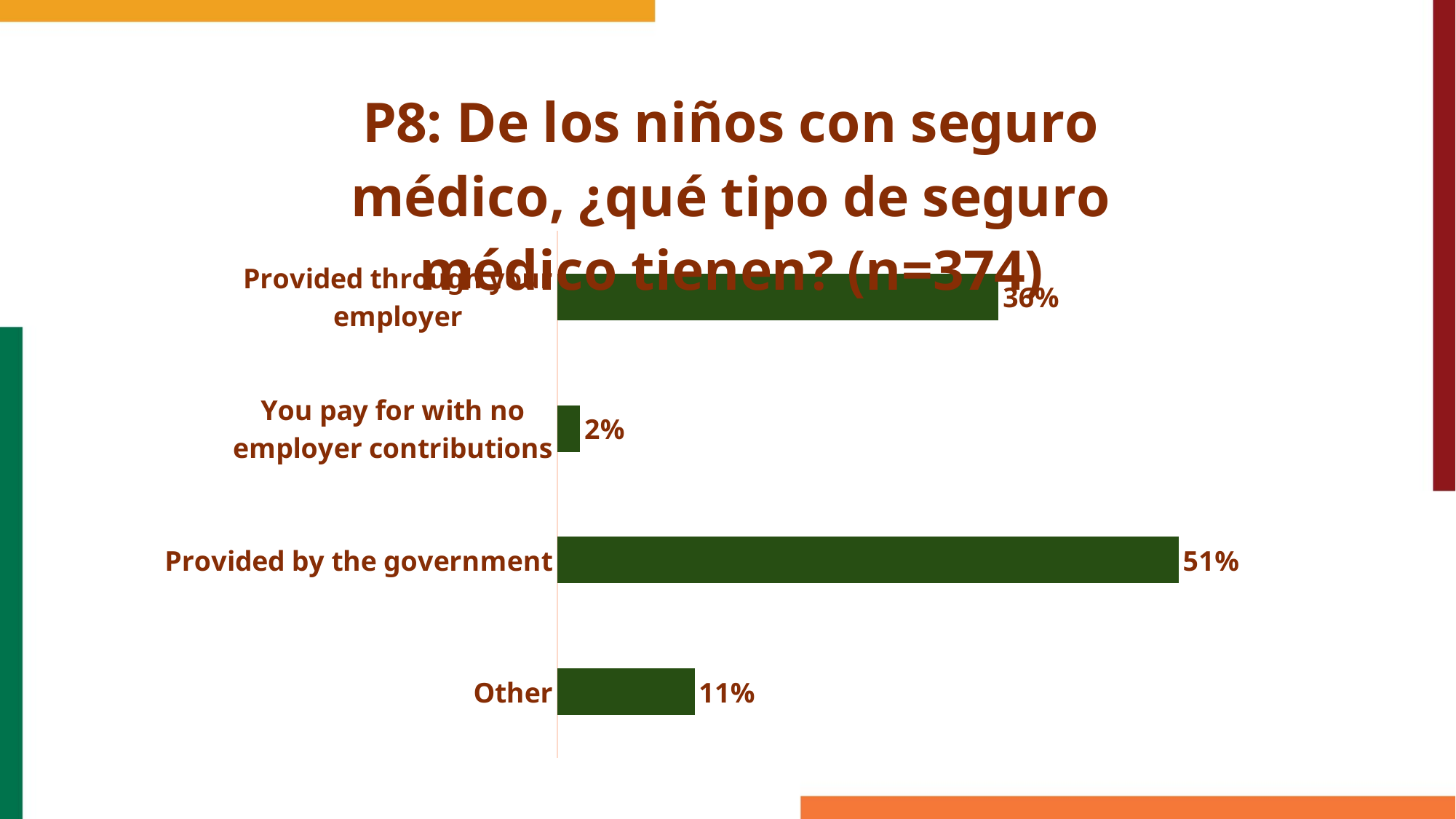
What is the difference between "Other" and "You pay for with no employer contributions"? 9 percentage points What is the value for "Provided by the government"? 51% Which is larger, the value for "Other" or the value for "You pay for with no employer contributions"? Other How many categories are shown in the chart? 4 Which category has the lowest value? You pay for with no employer contributions What is the value for "Provided through your employer"? 36% What kind of chart is shown on the slide? Bar chart What sample size (n) is given in the chart title? 374 What is the value for "You pay for with no employer contributions"? 2% What is the value for "Other"? 11% What is the difference between "Provided by the government" and "Other"? 40 percentage points Which category has the highest value? Provided by the government